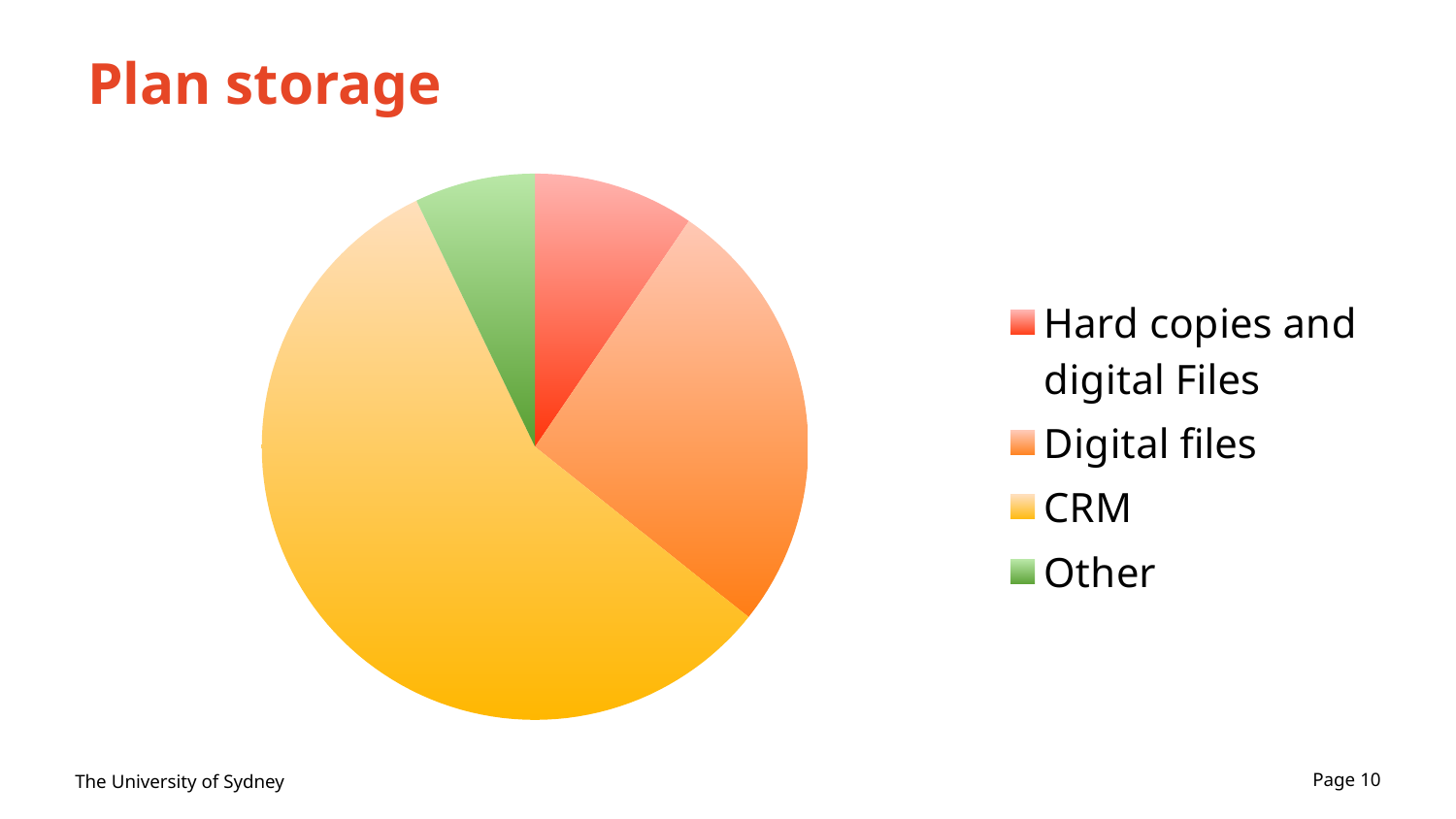
What kind of chart is shown on the slide? pie chart Does the CRM slice take up more or less than half of the pie chart? more How many entries does the legend of the pie chart list? 4 Which category is shown in green in the pie chart? Other Which slice is larger, Digital files or Hard copies and digital Files? Digital files Which category has the largest slice of the pie chart? CRM Which category has the smallest slice of the pie chart? Other How many slices does the pie chart have? 4 What is the title of the slide containing the pie chart? Plan storage Which slice is larger, Digital files or Other? Digital files